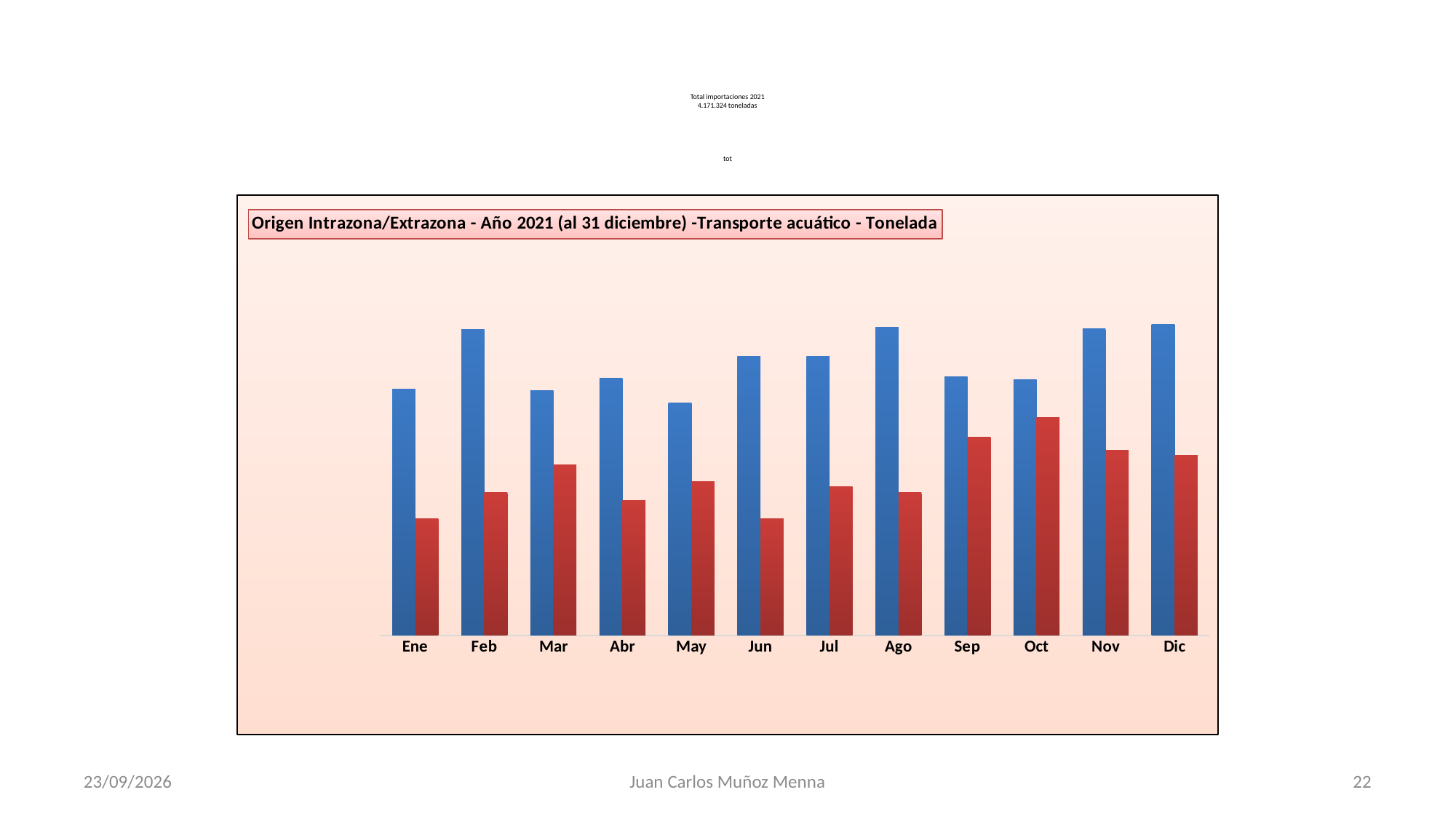
In Oct, which bar is taller, the blue one or the red one? blue Is the blue bar taller in Feb or in May? Feb In which month is the blue bar the lowest? May How many bars are plotted for each month in the chart? 2 In which month is the red bar the highest? Oct What is the title of the chart? Origen Intrazona/Extrazona - Año 2021 (al 31 diciembre) -Transporte acuático - Tonelada What colours are the two series of bars in the chart? blue and red How many months (categories) are shown along the x axis of the chart? 12 What is the first month shown on the x axis of the chart? Ene Is the red bar taller in Sep or in Jun? Sep What kind of chart is shown on the slide? bar chart